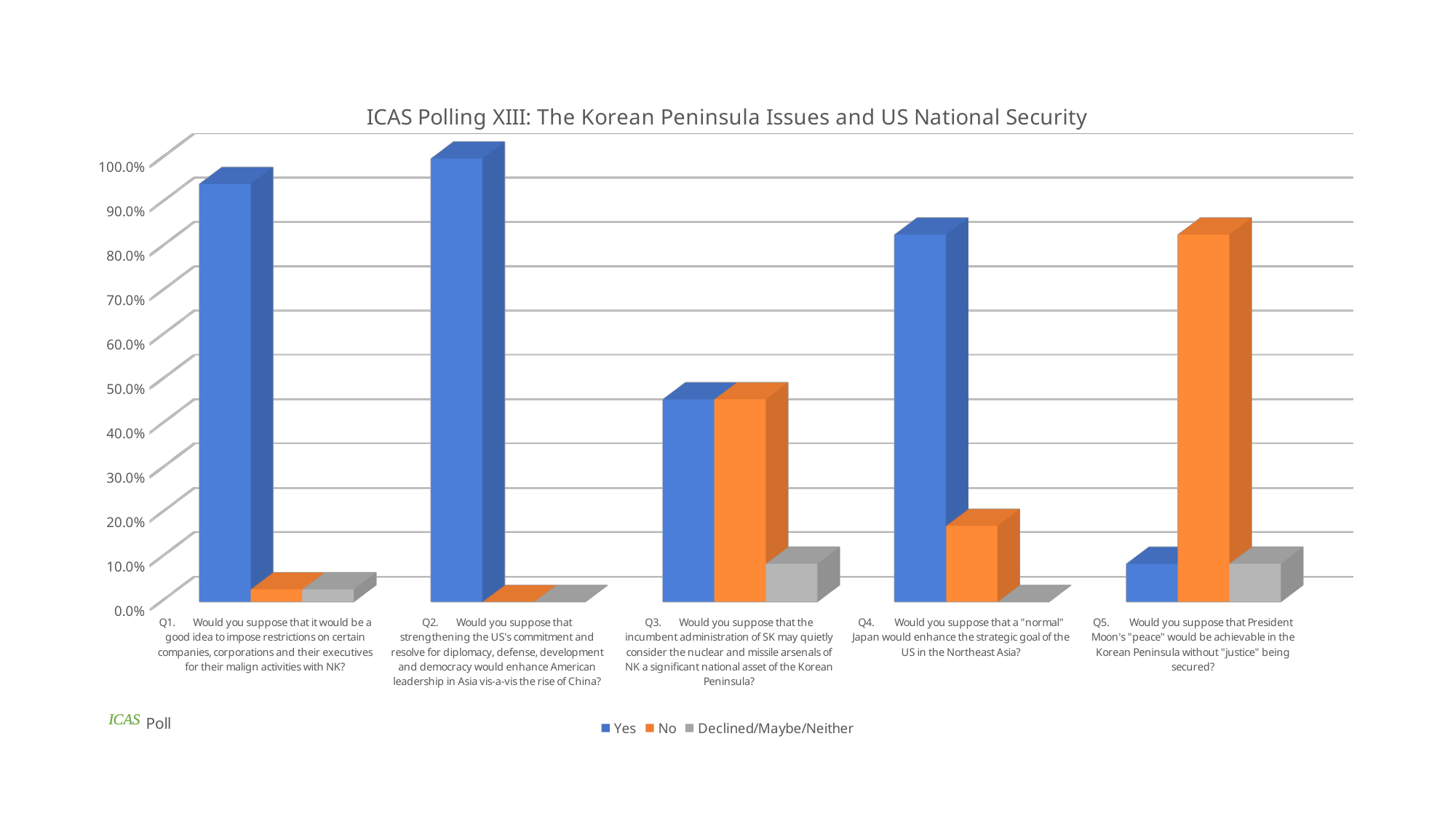
What kind of chart is shown on the slide? Bar chart Which poll question has the highest No value? Q5 How many series does the legend list? 3 Is the No value for Q5 greater or less than 70.0%? greater Which poll question has the highest Yes value? Q2 Which is larger, the Yes value for Q1 or the Yes value for Q4? Q1 Which poll question has the lowest Yes value? Q5 Is the No value for Q4 greater or less than 30.0%? less What are the three entries listed in the legend? Yes, No, Declined/Maybe/Neither For Q5, which is larger, the Yes value or the No value? No Is the Yes value for Q1 greater or less than 80.0%? greater How many poll questions (categories) are plotted on the x axis? 5